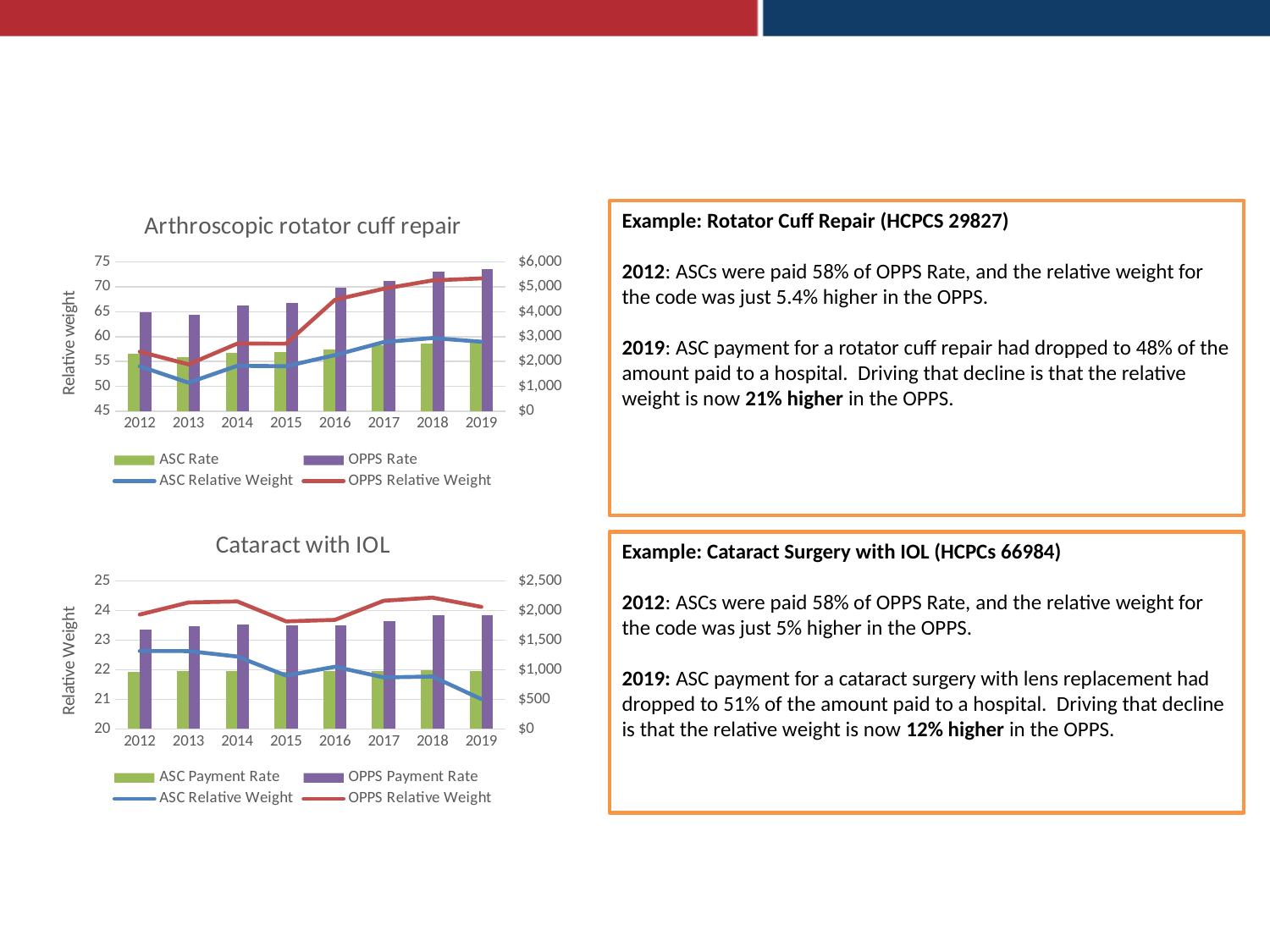
In the 'Cataract with IOL' chart, is the OPPS Relative Weight for 2018 greater or less than 24? greater In the 'Arthroscopic rotator cuff repair' chart, which year has the lowest OPPS Rate bar? 2013 In the 'Arthroscopic rotator cuff repair' chart, how many series does the legend list? 4 In the 'Arthroscopic rotator cuff repair' chart, does the OPPS Relative Weight line rise or fall from 2012 to 2019? rise In the 'Arthroscopic rotator cuff repair' chart, how many years are shown on the x axis? 8 In the 'Cataract with IOL' chart, does the ASC Relative Weight line rise or fall from 2012 to 2019? fall In the 'Arthroscopic rotator cuff repair' chart, which is larger: the OPPS Rate in 2012 or in 2019? 2019 In the 'Cataract with IOL' chart, which is larger: the ASC Relative Weight in 2012 or in 2019? 2012 What kind of chart is the 'Cataract with IOL' chart? A combination bar and line chart In the 'Arthroscopic rotator cuff repair' chart, which year has the highest OPPS Rate bar? 2019 In the 'Arthroscopic rotator cuff repair' chart, is the OPPS Rate for 2019 greater or less than $5,000? greater In the 'Cataract with IOL' chart, how many series does the legend list? 4